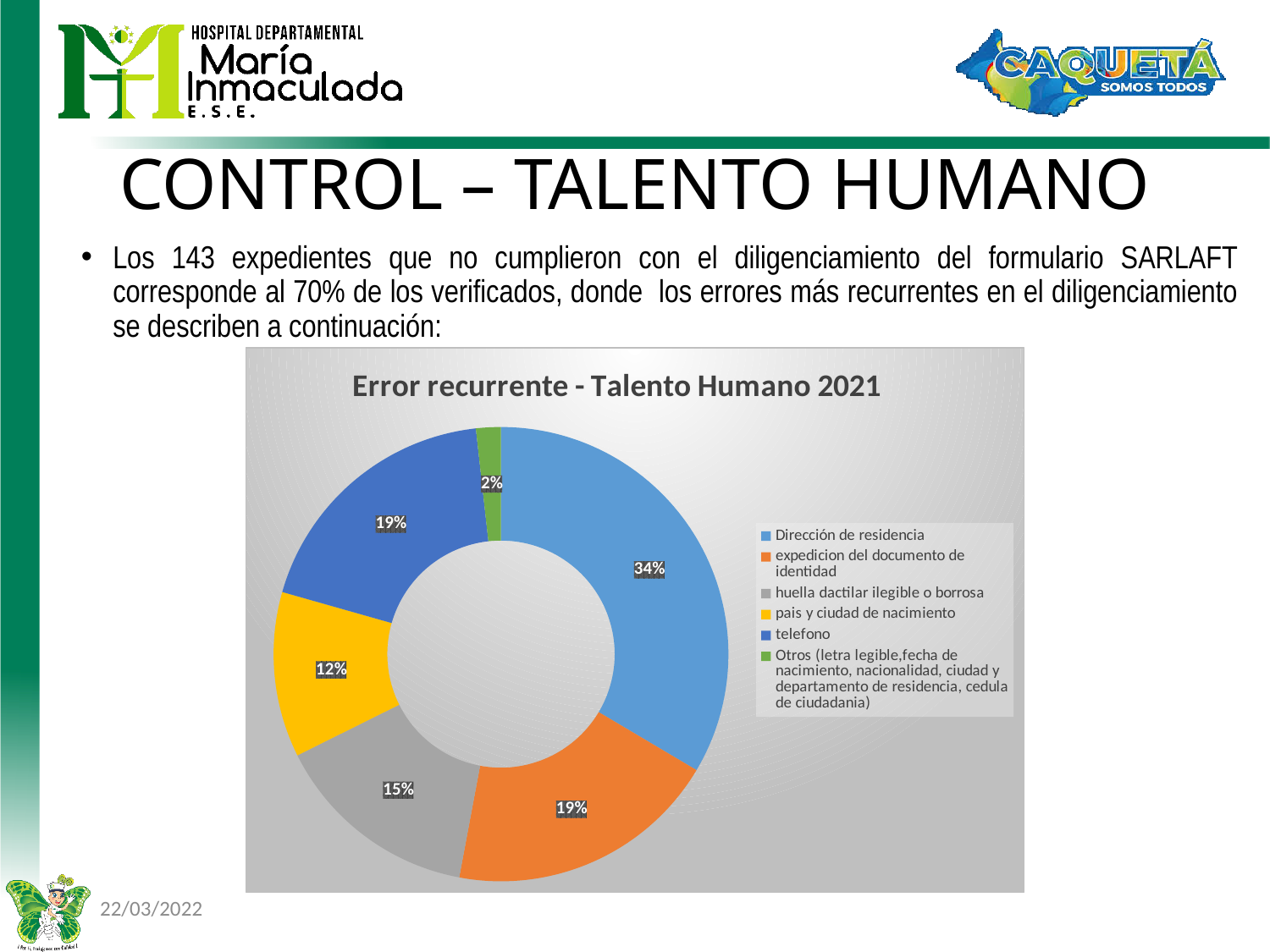
What percentage does the chart show for 'Dirección de residencia'? 34% Which is larger: the share for 'huella dactilar ilegible o borrosa' or for 'pais y ciudad de nacimiento'? huella dactilar ilegible o borrosa What kind of chart is shown on the slide? doughnut chart What percentage does the chart show for 'telefono'? 19% Which category has the largest share in the chart? Dirección de residencia What is the title of the chart on the slide? Error recurrente - Talento Humano 2021 What colour is the slice for 'expedicion del documento de identidad'? orange How many categories are shown in the chart? 6 What percentage does the chart show for 'huella dactilar ilegible o borrosa'? 15% What is the difference in percentage points between 'Dirección de residencia' and 'expedicion del documento de identidad'? 15 percentage points Which category has the smallest share in the chart? Otros (letra legible, fecha de nacimiento, nacionalidad, ciudad y departamento de residencia, cedula de ciudadania) What percentage does the chart show for 'pais y ciudad de nacimiento'? 12%